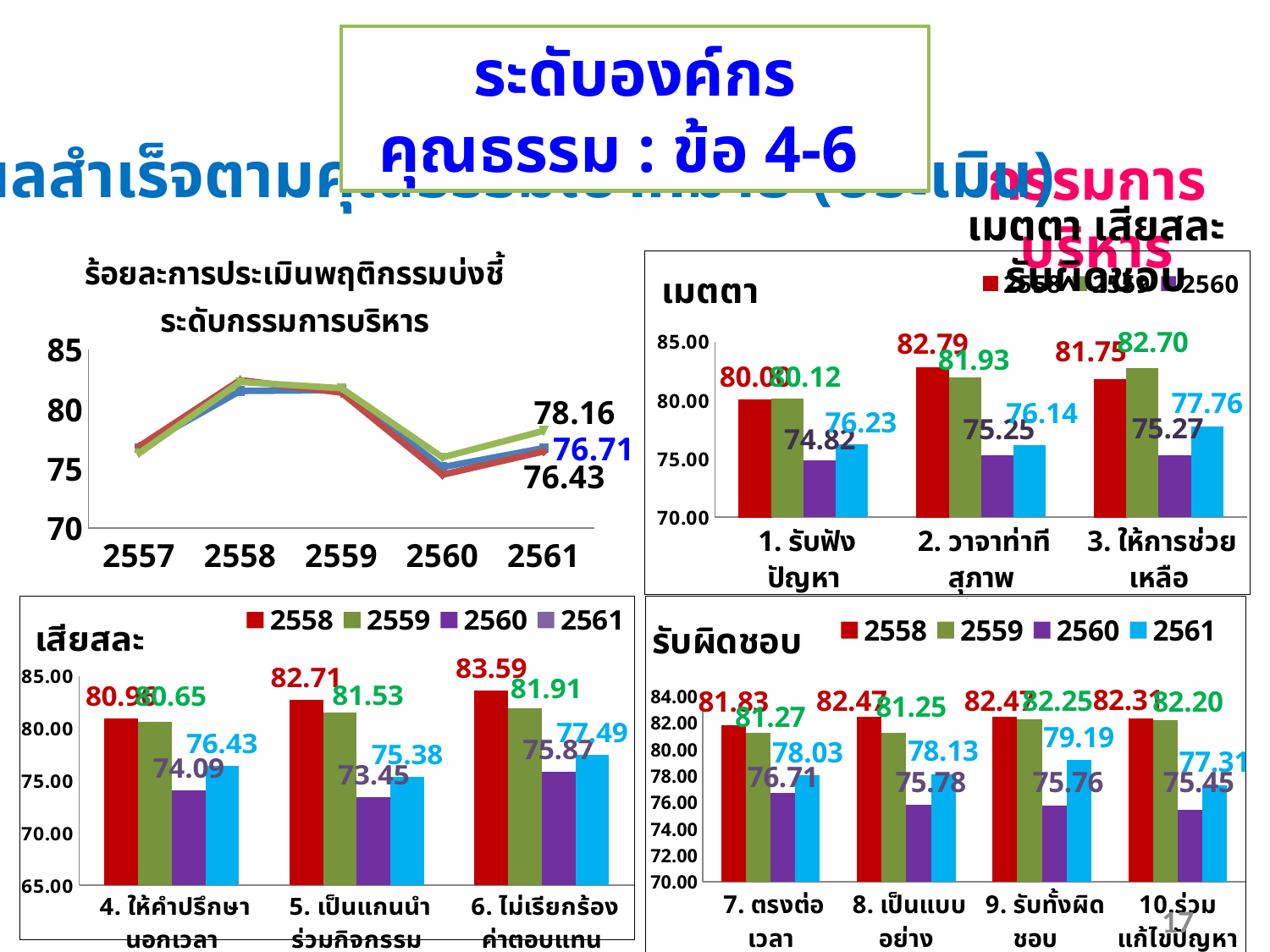
In the รับผิดชอบ chart, which category has the highest 2561 value? 9. รับทั้งผิดชอบ In the เสียสละ chart, which category has the lowest 2560 value? 5. เป็นแกนนำร่วมกิจกรรม In the รับผิดชอบ chart, is the 2560 value for 7. ตรงต่อเวลา larger or smaller than the 2560 value for 10. ร่วมแก้ไขปัญหา? larger In the เมตตา chart, what is the difference between the 2558 and 2561 values for 2. วาจาท่าทีสุภาพ? 6.65 In the เมตตา chart, what is the value for 2560 in category 1. รับฟังปัญหา? 74.82 What kind of chart is the top-left chart titled ร้อยละการประเมินพฤติกรรมบ่งชี้ ระดับกรรมการบริหาร? line chart In the เสียสละ chart, what is the value for 2561 in category 6. ไม่เรียกร้องค่าตอบแทน? 77.49 In the เมตตา chart, what is the value for 2559 in category 3. ให้การช่วยเหลือ? 82.70 In the รับผิดชอบ chart, what is the value for 2561 in category 9. รับทั้งผิดชอบ? 79.19 In the เสียสละ chart, how many series does the legend list? 4 In the รับผิดชอบ chart, how many categories are shown on the x axis? 4 In the top-left line chart, how many years are shown on the x axis? 5